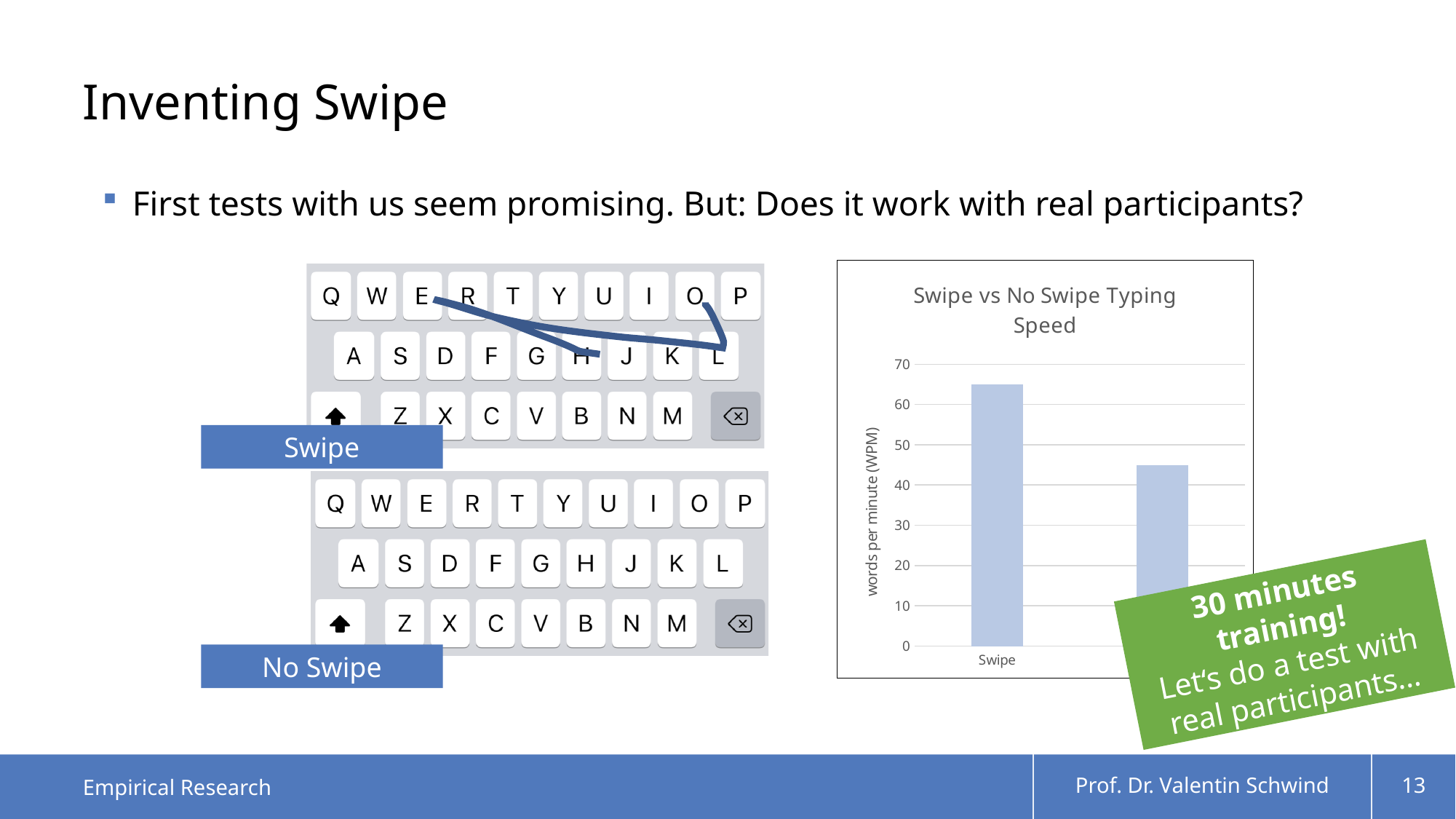
Is the value of the right-hand bar greater or less than 50? less What kind of chart is shown on the slide? bar chart Which is larger: the Swipe bar or the right-hand bar? Swipe Is the value for Swipe greater or less than 60? greater Is the value of the right-hand bar greater or less than 40? greater Which bar is the tallest in the chart? Swipe How many bars are plotted in the chart? 2 What is the label on the vertical axis of the chart? words per minute (WPM) What is the title of the chart? Swipe vs No Swipe Typing Speed What is the highest tick value shown on the vertical axis? 70